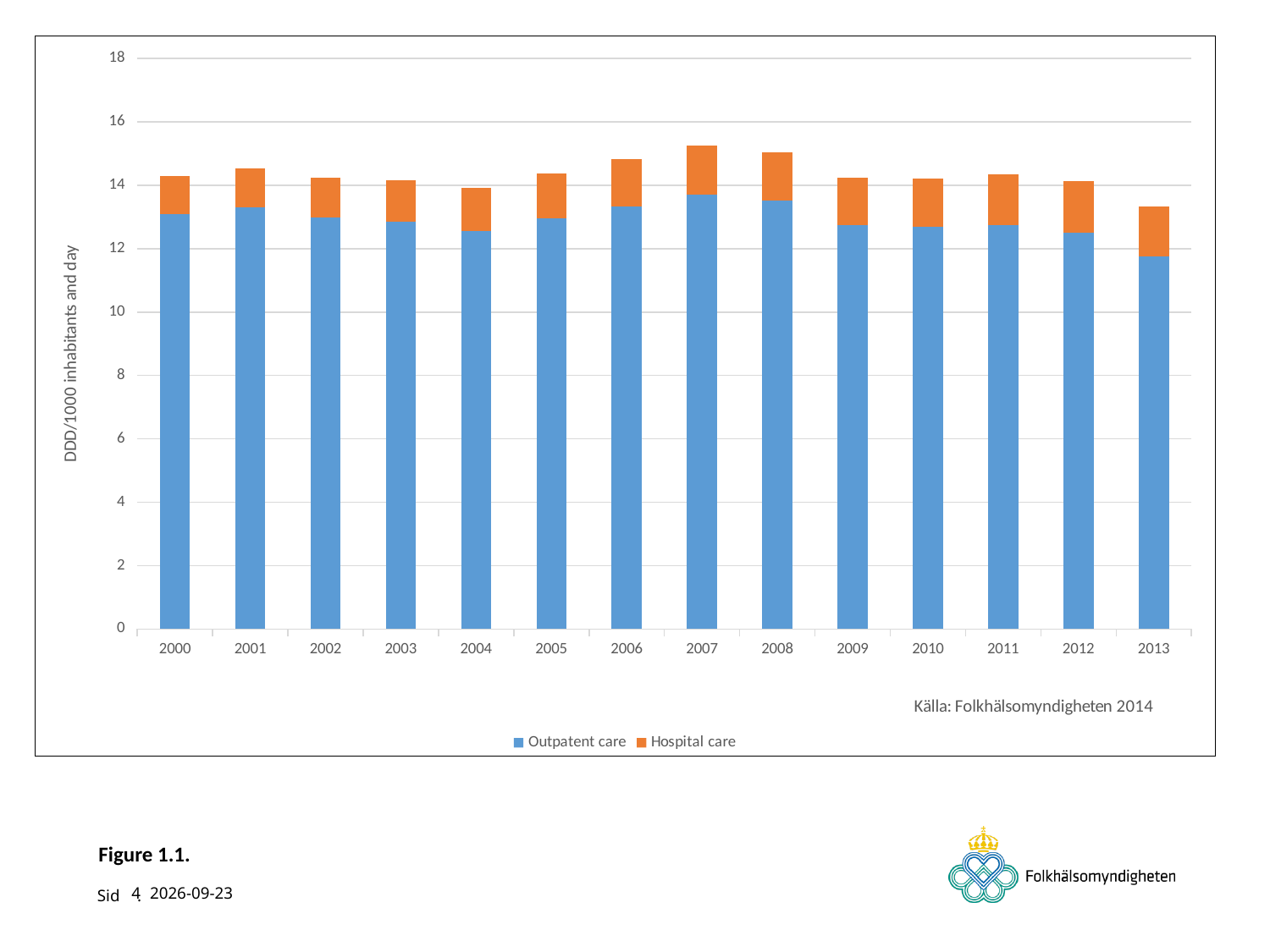
What is the label on the y axis of the chart? DDD/1000 inhabitants and day How many series does the chart's legend list? 2 What kind of chart is shown on the slide? Stacked bar chart Which year has the highest total bar in the chart? 2007 Is the total value for 2013 greater or less than 14? less Which year has the lowest Outpatent care value? 2013 Is the total value for 2007 greater or less than 14? greater Is the Outpatent care value for 2000 greater or less than 12? greater Do the total bar values rise or fall from 2008 to 2013? fall Which year has the lowest total bar in the chart? 2013 How many years are shown along the x axis of the chart? 14